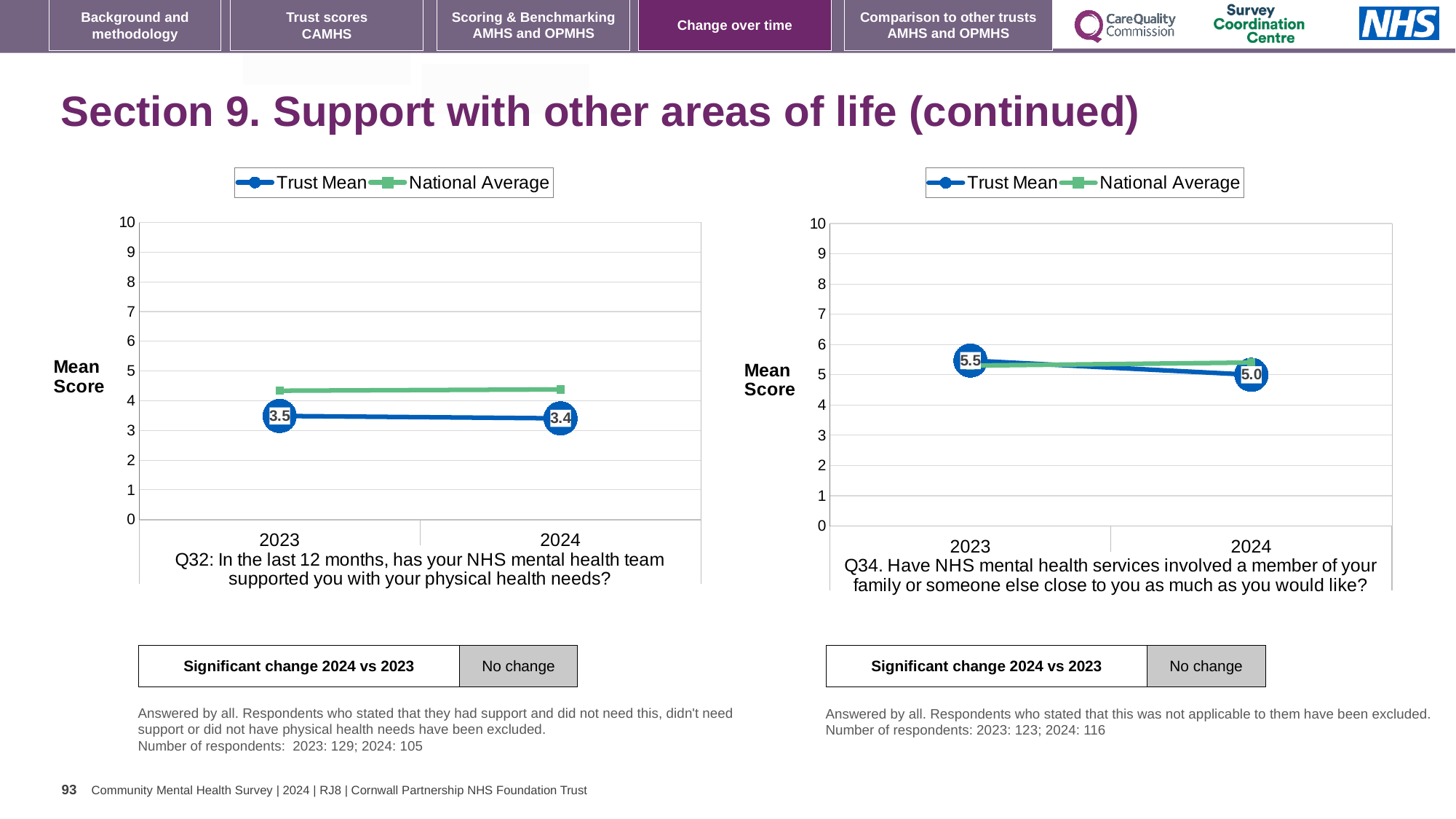
In the Q32 chart (left), what is the difference between the Trust Mean in 2023 and 2024? 0.1 How many series does the legend of the Q32 chart (left) list? 2 In the Q34 chart (right), which is higher in 2024, the Trust Mean or the National Average? National Average In the Q34 chart (right), does the Trust Mean rise or fall from 2023 to 2024? fall In the Q34 chart (right), what is the Trust Mean score for 2024? 5.0 In the Q34 chart (right), what is the Trust Mean score for 2023? 5.5 In the Q32 chart (left), what is the Trust Mean score for 2023? 3.5 In the Q32 chart (left), what is the Trust Mean score for 2024? 3.4 In the Q32 chart (left), is the National Average for 2023 greater or less than 4? greater In the Q32 chart (left), which is higher in 2024, the Trust Mean or the National Average? National Average In the Q34 chart (right), by how much did the Trust Mean change from 2023 to 2024? 0.5 What type of chart is the Q34 chart (right)? line chart